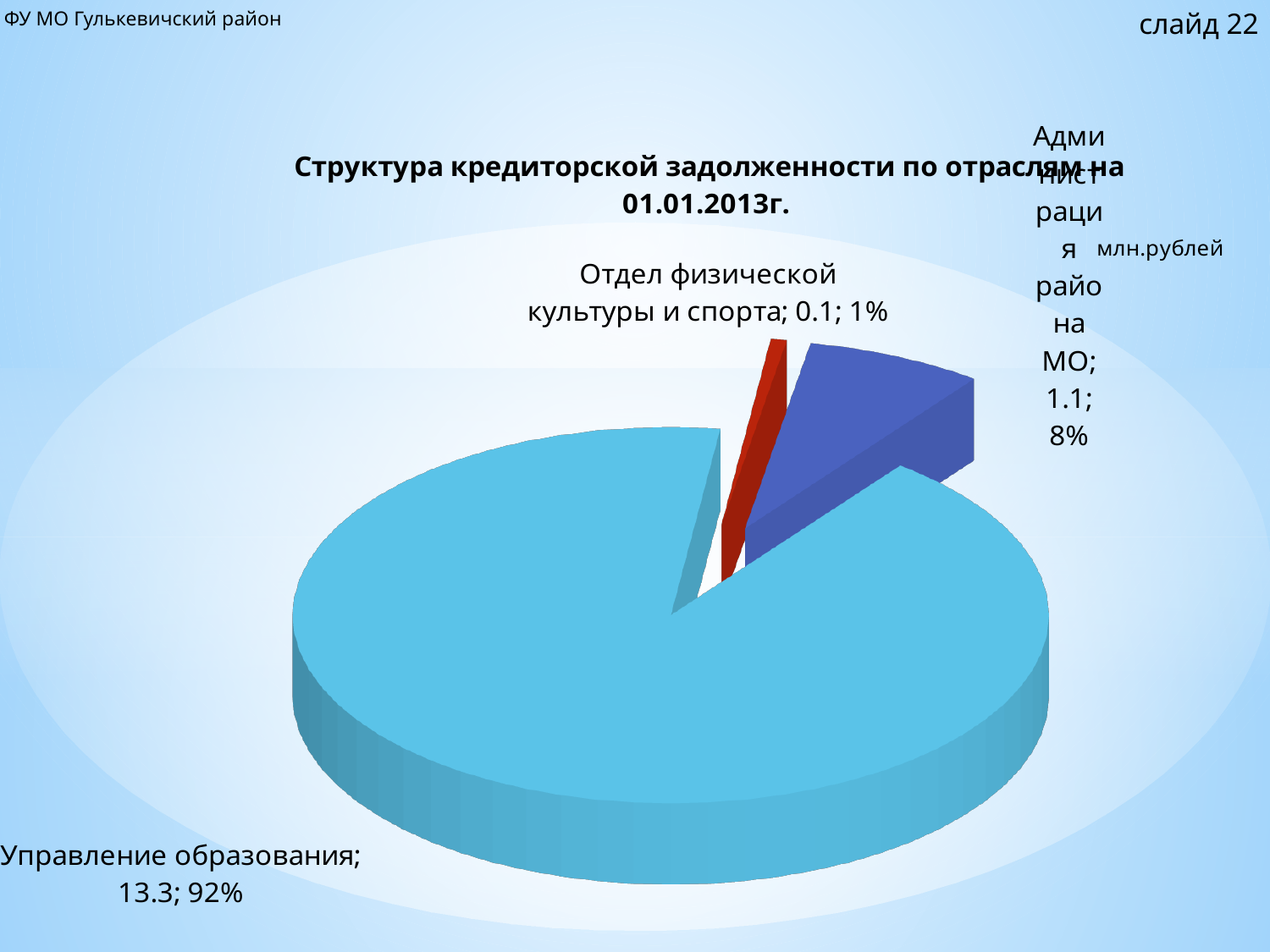
Which is larger, the value for Администрация района МО or for Отдел физической культуры и спорта? Администрация района МО What is the value for Отдел физической культуры и спорта? 0.1 What share of the pie does Администрация района МО take? 8% What share of the pie does Управление образования take? 92% What kind of chart is shown on the slide? pie chart Which category has the smallest slice? Отдел физической культуры и спорта How many slices does the pie chart have? 3 What is the value for Администрация района МО? 1.1 Which category has the largest slice? Управление образования What is the value for Управление образования? 13.3 What is the title of the chart? Структура кредиторской задолженности по отраслям на 01.01.2013г. What is the difference between the values for Управление образования and Администрация района МО? 12.2